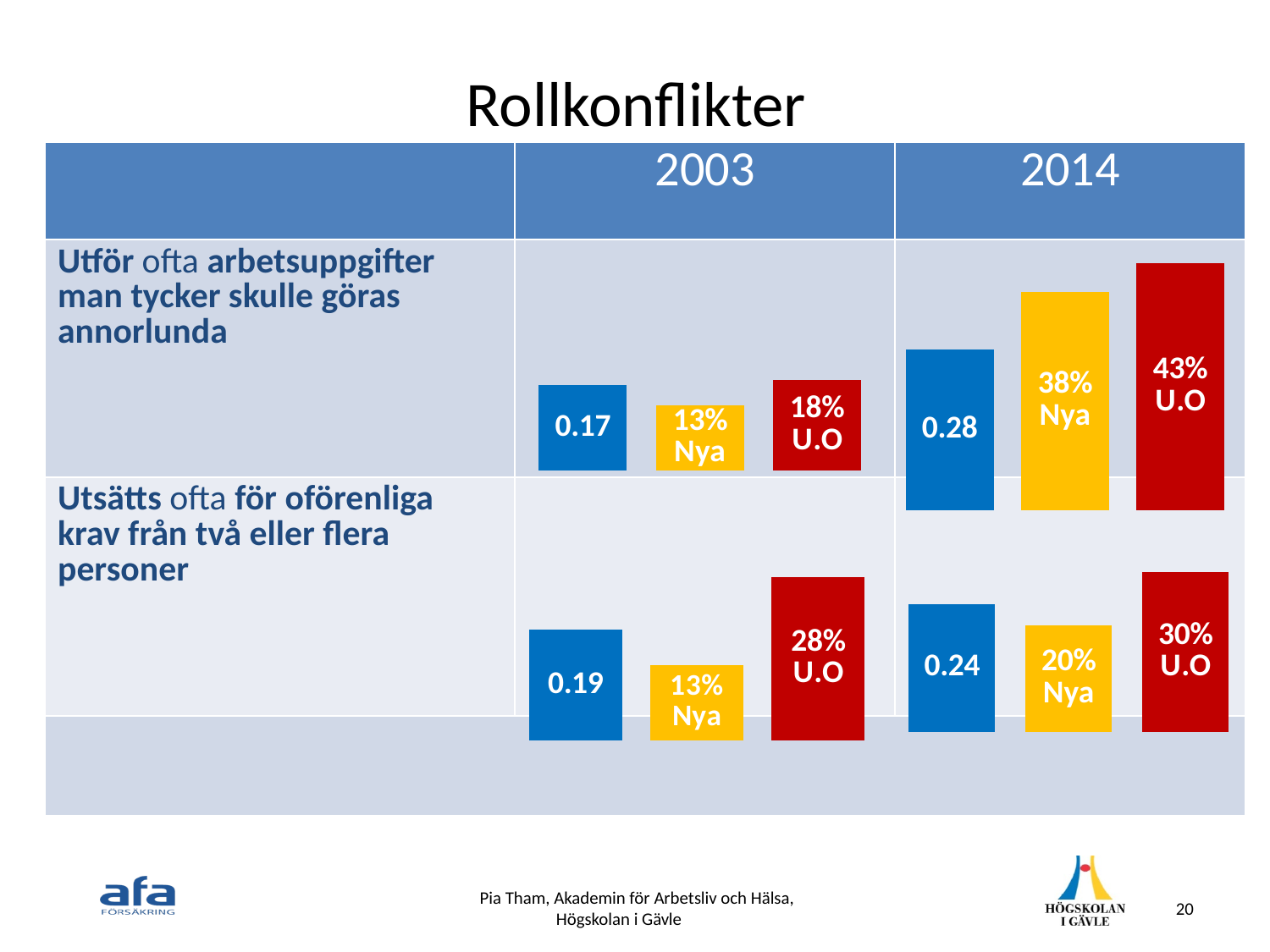
In the 2014 column for 'Utför ofta arbetsuppgifter man tycker skulle göras annorlunda', what is the value shown for U.O? 43% For 'Utsätts ofta för oförenliga krav från två eller flera personer', is the U.O value in 2003 larger or smaller than the Nya value in 2014? larger For 'Utför ofta arbetsuppgifter man tycker skulle göras annorlunda', is the Nya value larger in 2003 or in 2014? 2014 In the 2003 column for 'Utsätts ofta för oförenliga krav från två eller flera personer', which group has the lowest value? Nya In the 2014 column for 'Utsätts ofta för oförenliga krav från två eller flera personer', what is the value shown for Nya? 20% In the 2003 column for 'Utför ofta arbetsuppgifter man tycker skulle göras annorlunda', what is the value shown for Nya? 13% What is the title of the slide containing these charts? Rollkonflikter For 'Utför ofta arbetsuppgifter man tycker skulle göras annorlunda', what is the difference between the U.O value in 2014 and the U.O value in 2003? 25 percentage points In the 2003 column for 'Utsätts ofta för oförenliga krav från två eller flera personer', what value is printed on the blue bar? 0.19 For 'Utsätts ofta för oförenliga krav från två eller flera personer', what is the difference between the Nya value in 2014 and the Nya value in 2003? 7 percentage points How many bars are shown in each year column for each statement? 3 In the 2014 column for 'Utför ofta arbetsuppgifter man tycker skulle göras annorlunda', which group has the highest value? U.O